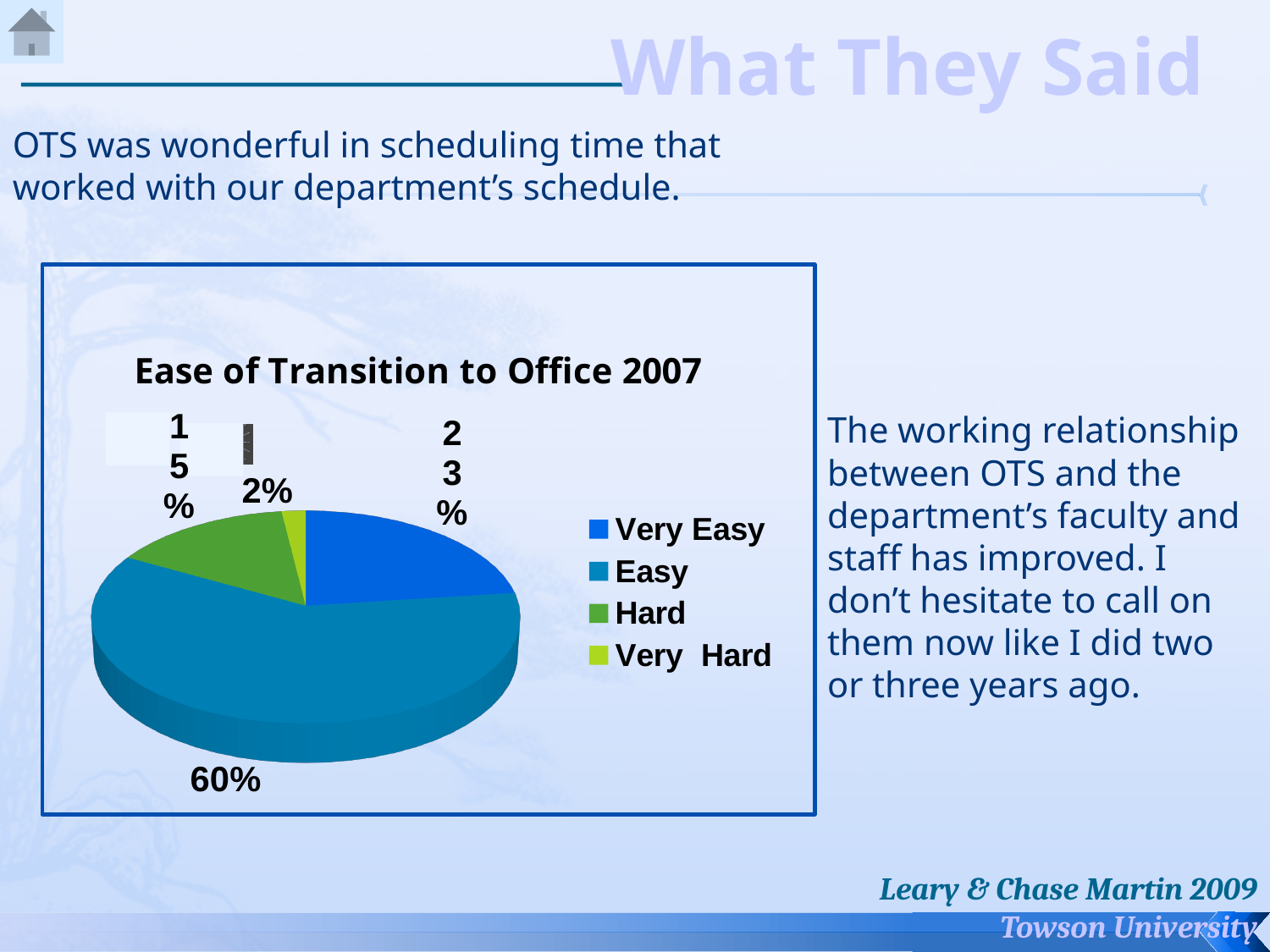
What percentage of respondents said the transition was Easy? 60% How many categories does the legend list? 4 What kind of chart is shown on the slide? pie chart Which category has the smallest share of the pie? Very Hard What colour is the Very Hard slice in the legend? light green What is the title of the chart? Ease of Transition to Office 2007 Which category has the largest share of the pie? Easy What percentage of respondents said the transition was Very Easy? 23% What percentage of respondents said the transition was Very Hard? 2% What percentage of respondents said the transition was Hard? 15% Which is larger, the share for Very Easy or the share for Hard? Very Easy What is the difference in percentage points between Easy and Very Easy? 37